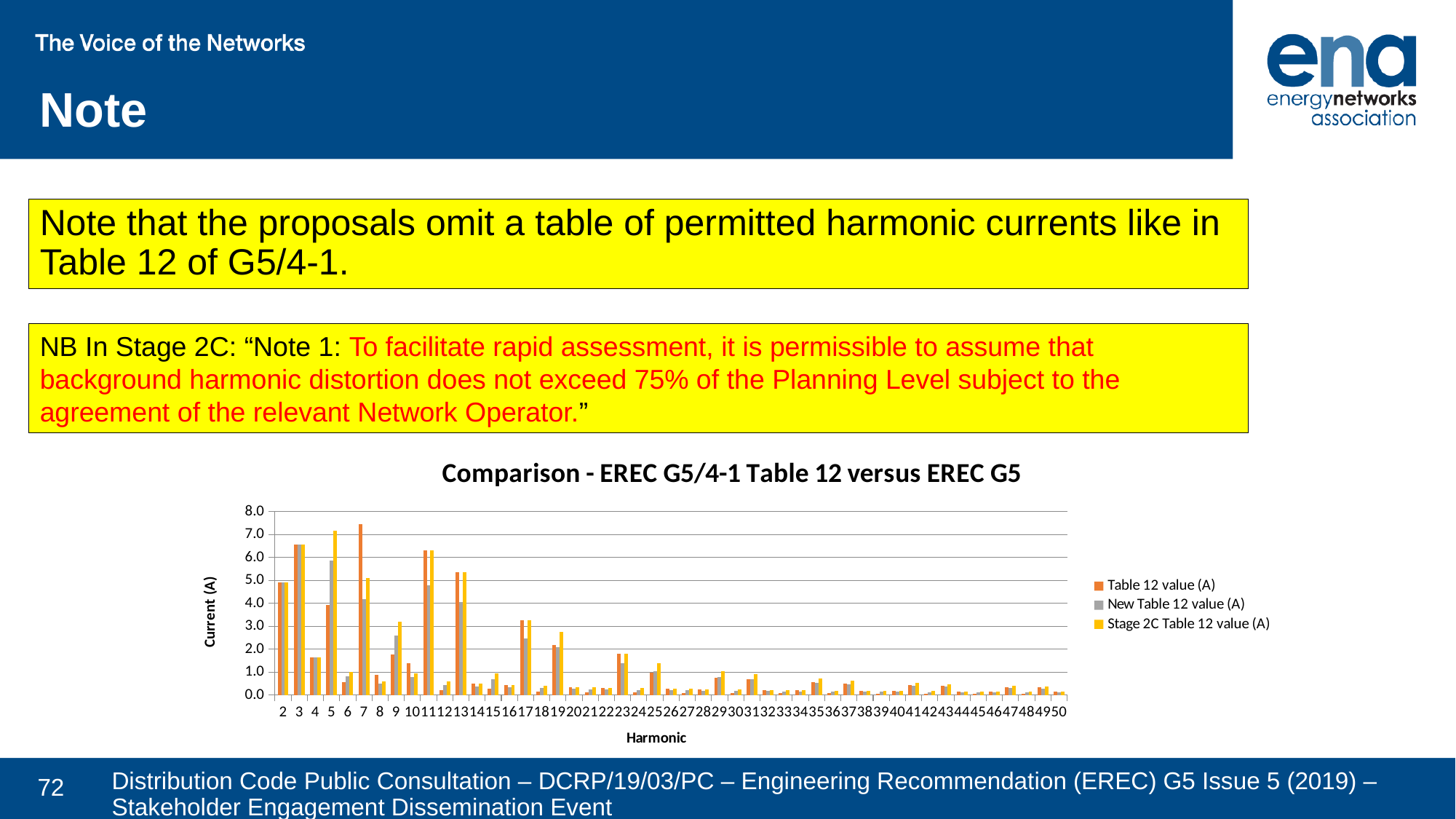
How many series does the legend of the chart list? 3 Is the Table 12 value (A) at harmonic 7 greater or less than 7.0? greater How many harmonic categories are plotted along the x axis of the chart? 49 Is the New Table 12 value (A) at harmonic 5 greater or less than 5.0? greater What type of chart is shown on the slide? Bar chart What is the label of the vertical axis of the chart? Current (A) Is the Stage 2C Table 12 value (A) at harmonic 5 greater or less than 6.0? greater At which harmonic is the Table 12 value (A) highest? 7 At harmonic 7, which is larger: the Table 12 value (A) or the New Table 12 value (A)? Table 12 value (A) At harmonic 5, which is larger: the Table 12 value (A) or the Stage 2C Table 12 value (A)? Stage 2C Table 12 value (A) What is the title of the chart? Comparison - EREC G5/4-1 Table 12 versus EREC G5